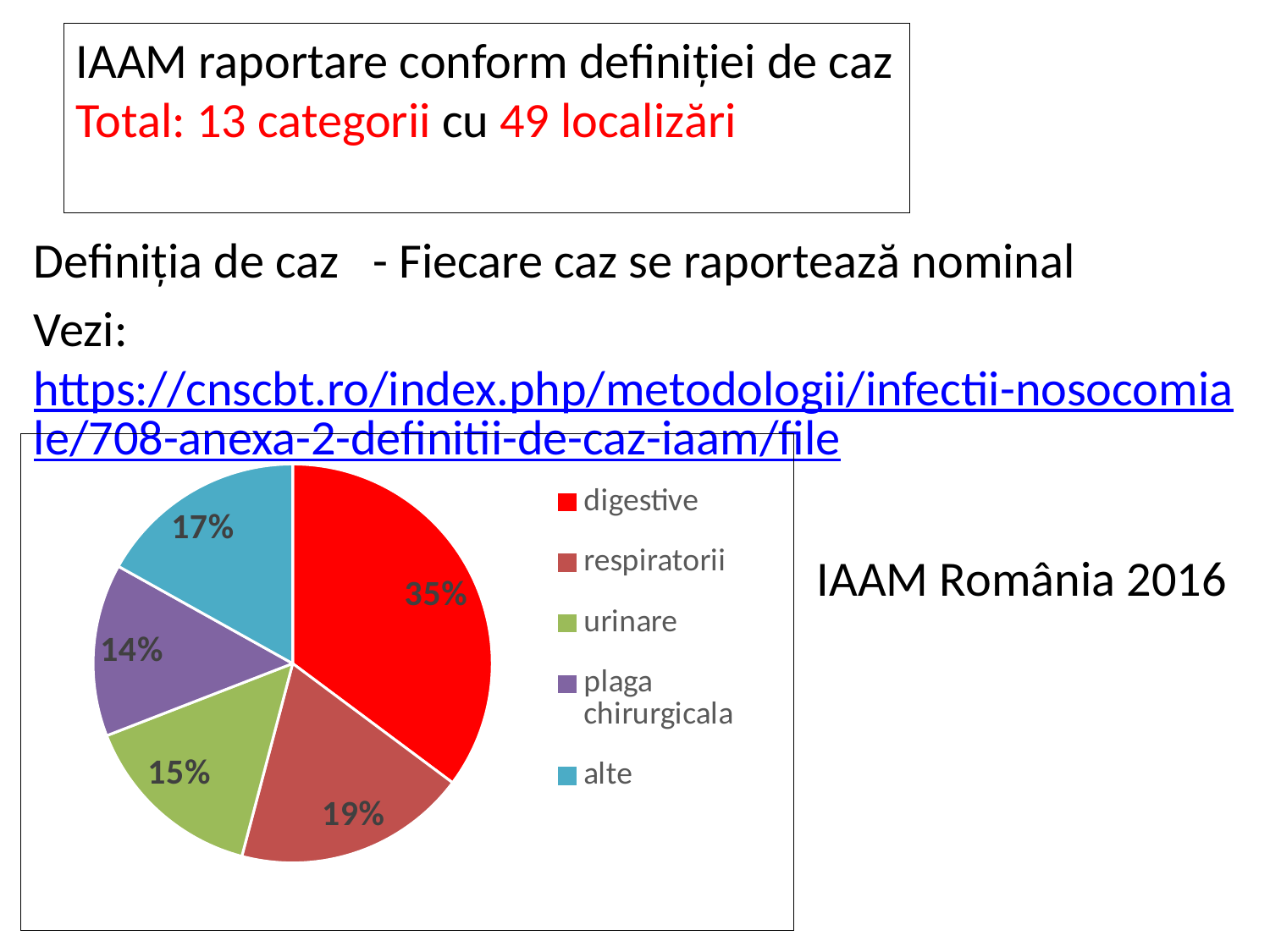
What share of the pie does the digestive slice represent? 35% What share of the pie does the plaga chirurgicala slice represent? 14% Which category has the smallest slice of the pie? plaga chirurgicala What share of the pie does the alte slice represent? 17% What is the difference in percentage points between the digestive and respiratorii slices? 16 Which category has the largest slice of the pie? digestive Which slice is larger, alte or urinare? alte How many categories are shown in the pie chart? 5 What type of chart is shown on the slide? pie chart What colour is the digestive slice in the pie chart? red